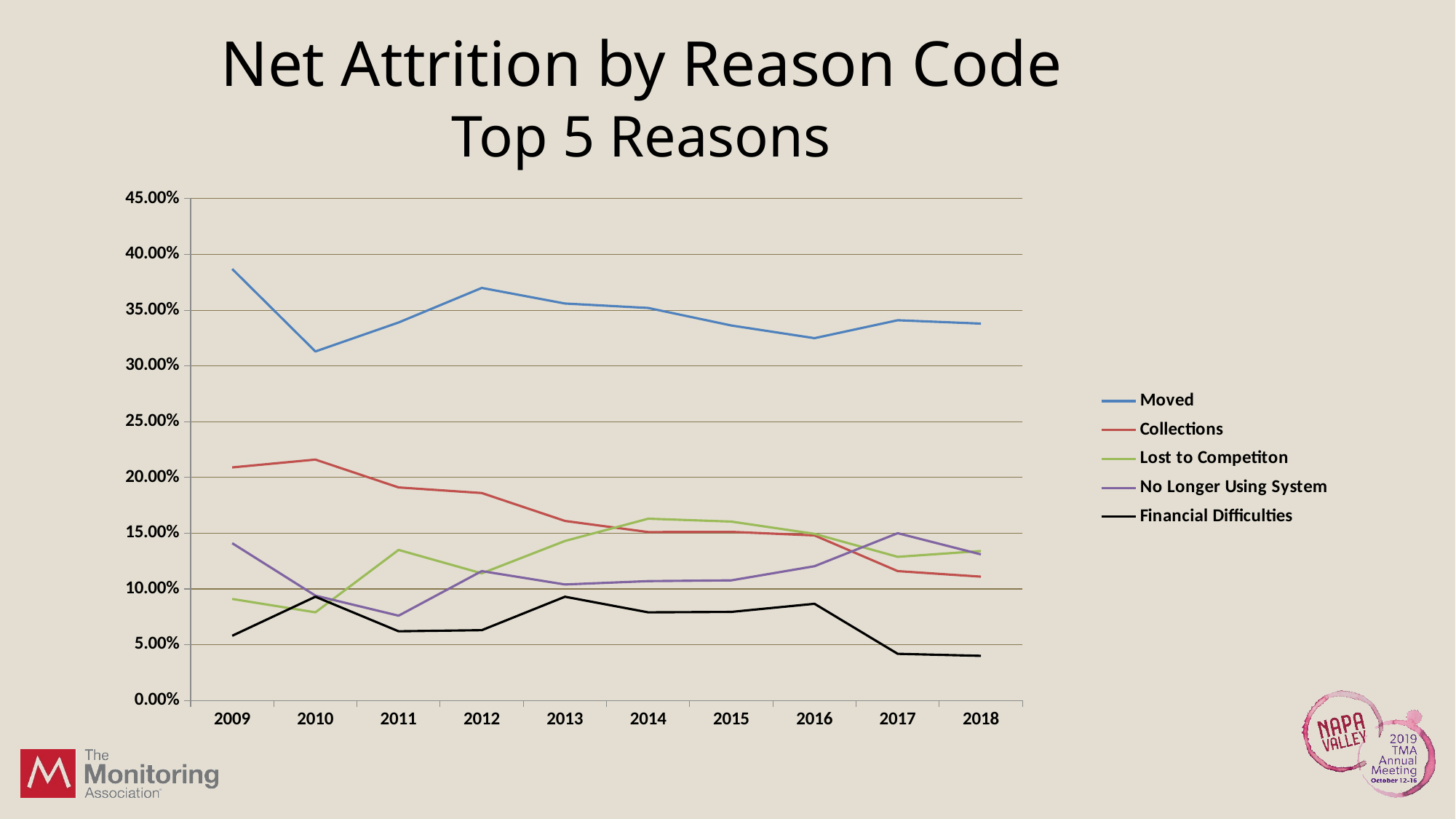
In 2018, which is larger: Collections or Lost to Competiton? Lost to Competiton Which reason code has the highest net attrition in 2009? Moved What colour is the line for Moved? blue Is the value for Collections in 2010 greater or less than 20.00%? greater Does the Financial Difficulties line rise or fall from 2016 to 2018? fall How many series does the legend list? 5 Is the value for Moved in 2010 greater or less than 30.00%? greater Is the value for Financial Difficulties in 2017 greater or less than 5.00%? less How many years are shown along the x axis? 10 Which reason code has the lowest net attrition in 2018? Financial Difficulties In which year is the value for Moved highest? 2009 What kind of chart is shown on the slide? line chart